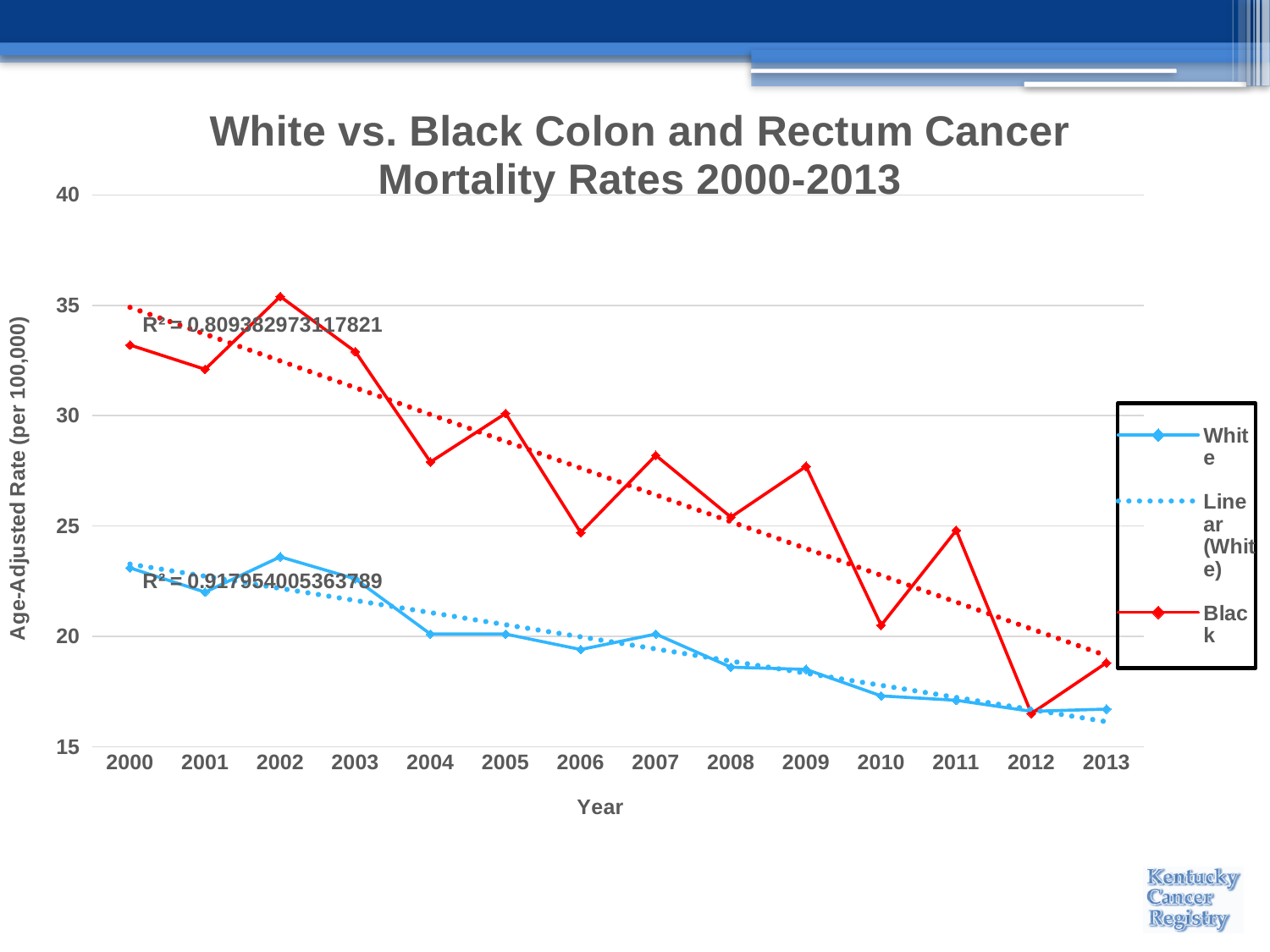
In which year is the Black mortality rate highest? 2002 In which year is the White mortality rate highest? 2002 Which series has the larger value in 2005, White or Black? Black What R² value is shown for the Black trendline? R² = 0.809382973117821 In which year is the Black mortality rate lowest? 2012 Is the White mortality rate in 2000 greater or less than 20? greater How many years are plotted along the x axis? 14 How many entries does the legend list? 3 What kind of chart is shown on the slide? Line chart Is the Black mortality rate in 2010 greater or less than 25? less Is the Black mortality rate in 2004 greater or less than 30? less Does the White mortality rate generally rise or fall from 2000 to 2013? Fall